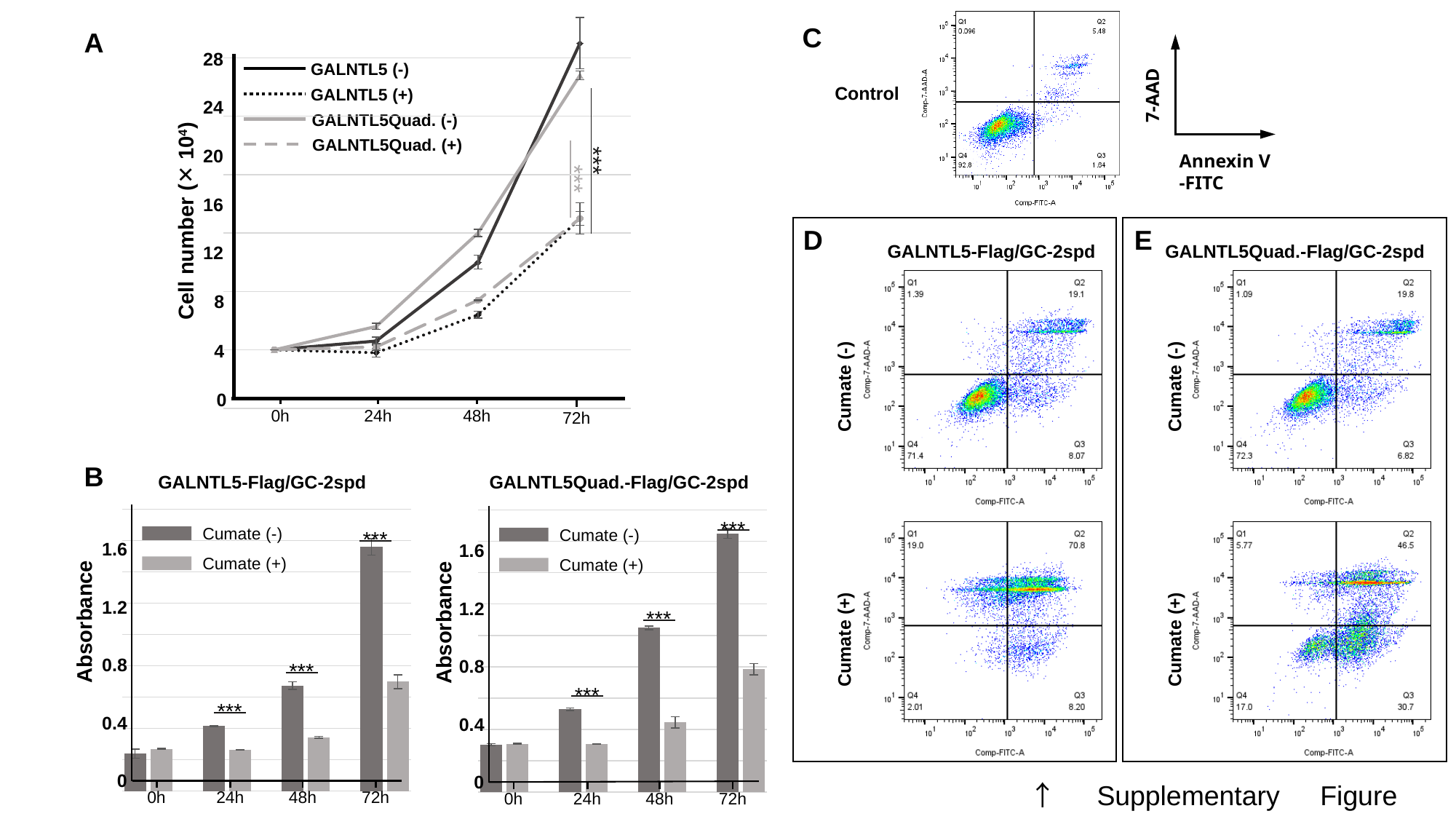
In the GALNTL5Quad.-Flag/GC-2spd chart of panel B, which series has the higher absorbance at 72h, Cumate (-) or Cumate (+)? Cumate (-) In panel A, do the cell numbers rise or fall from 0h to 72h? rise In the GALNTL5Quad.-Flag/GC-2spd chart of panel B, is the Cumate (+) absorbance at 48h greater or less than 0.8? less In panel A, how many series does the legend list? 4 In panel C (Control), what is the percentage shown in quadrant Q4? 92.8 In panel A, is the cell number for GALNTL5 (-) at 72h greater or less than 28? greater In panel D, what is the Q2 percentage for the Cumate (+) plot? 70.8 In panel A, how many time points are plotted along the x axis? 4 In panel A, is the cell number for GALNTL5 (+) at 72h greater or less than 16? less In panel D, what is the difference between the Q2 percentage for Cumate (+) and the Q2 percentage for Cumate (-)? 51.7 What kind of chart is the GALNTL5-Flag/GC-2spd chart in panel B? bar chart